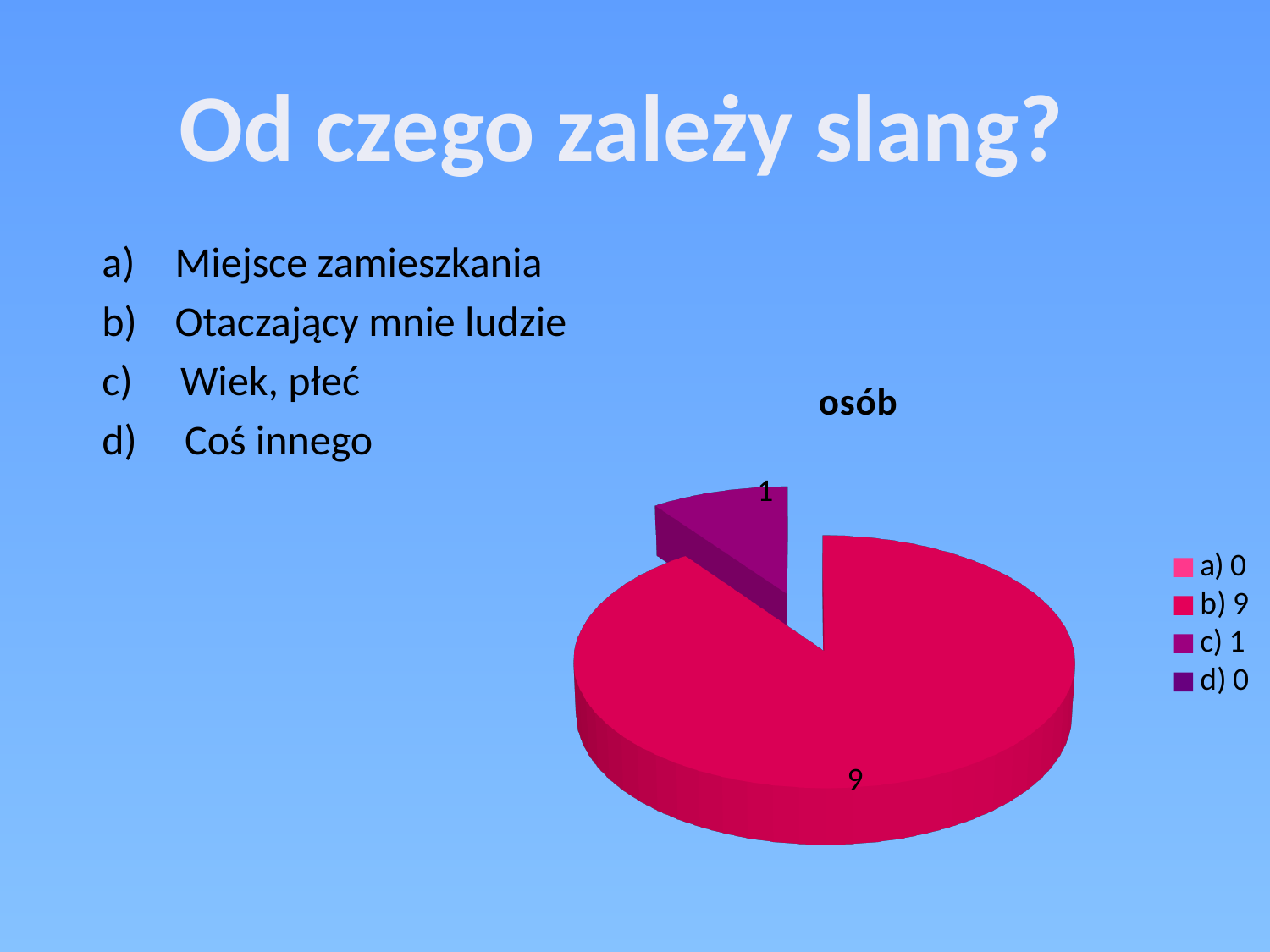
What is the value for category b) in the chart? 9 What share of the pie does category b) represent? 90% Which category has the largest slice of the pie? b) What is the title of the chart? osób What is the total of all values shown in the pie chart? 10 Which is larger, the value for b) or the value for c)? b) What is the difference between the values for b) and c)? 8 What is the value for category a) in the chart? 0 How many entries does the chart legend list? 4 What is the value for category d) in the chart? 0 What is the value for category c) in the chart? 1 What kind of chart is shown on the slide? pie chart